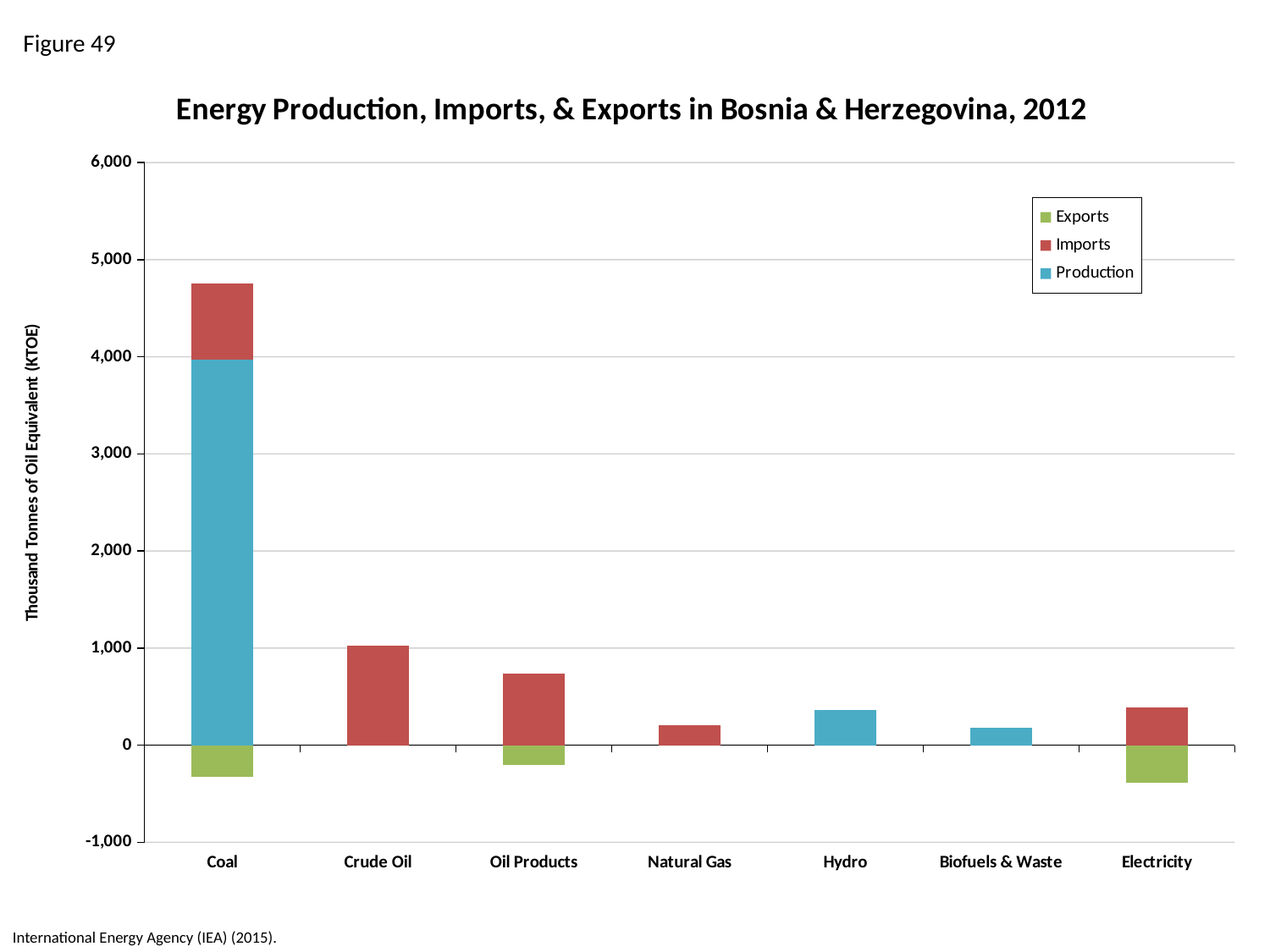
What kind of chart is shown on the slide? Stacked bar chart Which has the larger Imports value, Coal or Crude Oil? Crude Oil What is the title of the y axis? Thousand Tonnes of Oil Equivalent (KTOE) Which series is shown in green in the legend? Exports Which has the larger Production value, Hydro or Biofuels & Waste? Hydro Which category has the highest Production value? Coal Which has the larger Imports value, Crude Oil or Oil Products? Crude Oil Is the Imports value for Crude Oil greater or less than 500? greater How many series does the legend list? 3 Is the Imports value for Natural Gas greater or less than 500? less How many energy categories are shown along the x axis? 7 Is the Production value for Coal greater or less than 3,000? greater